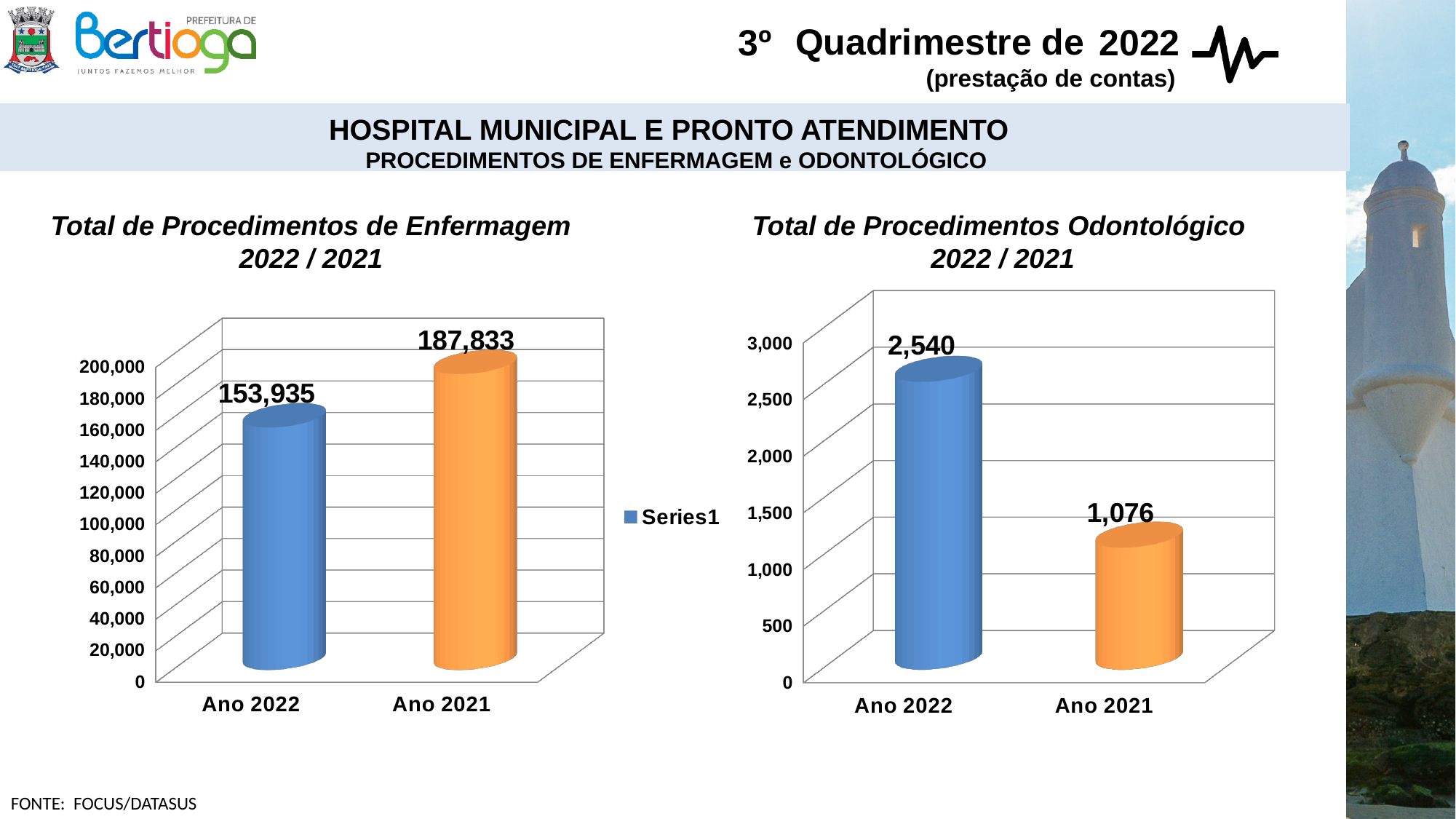
What legend entry is shown between the two charts? Series1 In the 'Total de Procedimentos Odontológico 2022 / 2021' chart, what is the difference between the Ano 2022 and Ano 2021 values? 1,464 In the 'Total de Procedimentos Odontológico 2022 / 2021' chart, which year has the lower value? Ano 2021 How many categories are shown in the 'Total de Procedimentos de Enfermagem 2022 / 2021' chart? 2 In the 'Total de Procedimentos de Enfermagem 2022 / 2021' chart, what is the value for Ano 2021? 187,833 In the 'Total de Procedimentos de Enfermagem 2022 / 2021' chart, what is the difference between the Ano 2021 and Ano 2022 values? 33,898 In the 'Total de Procedimentos Odontológico 2022 / 2021' chart, is the value for Ano 2022 larger or smaller than the value for Ano 2021? larger In the 'Total de Procedimentos Odontológico 2022 / 2021' chart, what is the value for Ano 2022? 2,540 What kind of chart is the 'Total de Procedimentos Odontológico 2022 / 2021' chart? bar chart In the 'Total de Procedimentos de Enfermagem 2022 / 2021' chart, which year has the higher value? Ano 2021 In the 'Total de Procedimentos Odontológico 2022 / 2021' chart, what is the value for Ano 2021? 1,076 In the 'Total de Procedimentos de Enfermagem 2022 / 2021' chart, what is the value for Ano 2022? 153,935